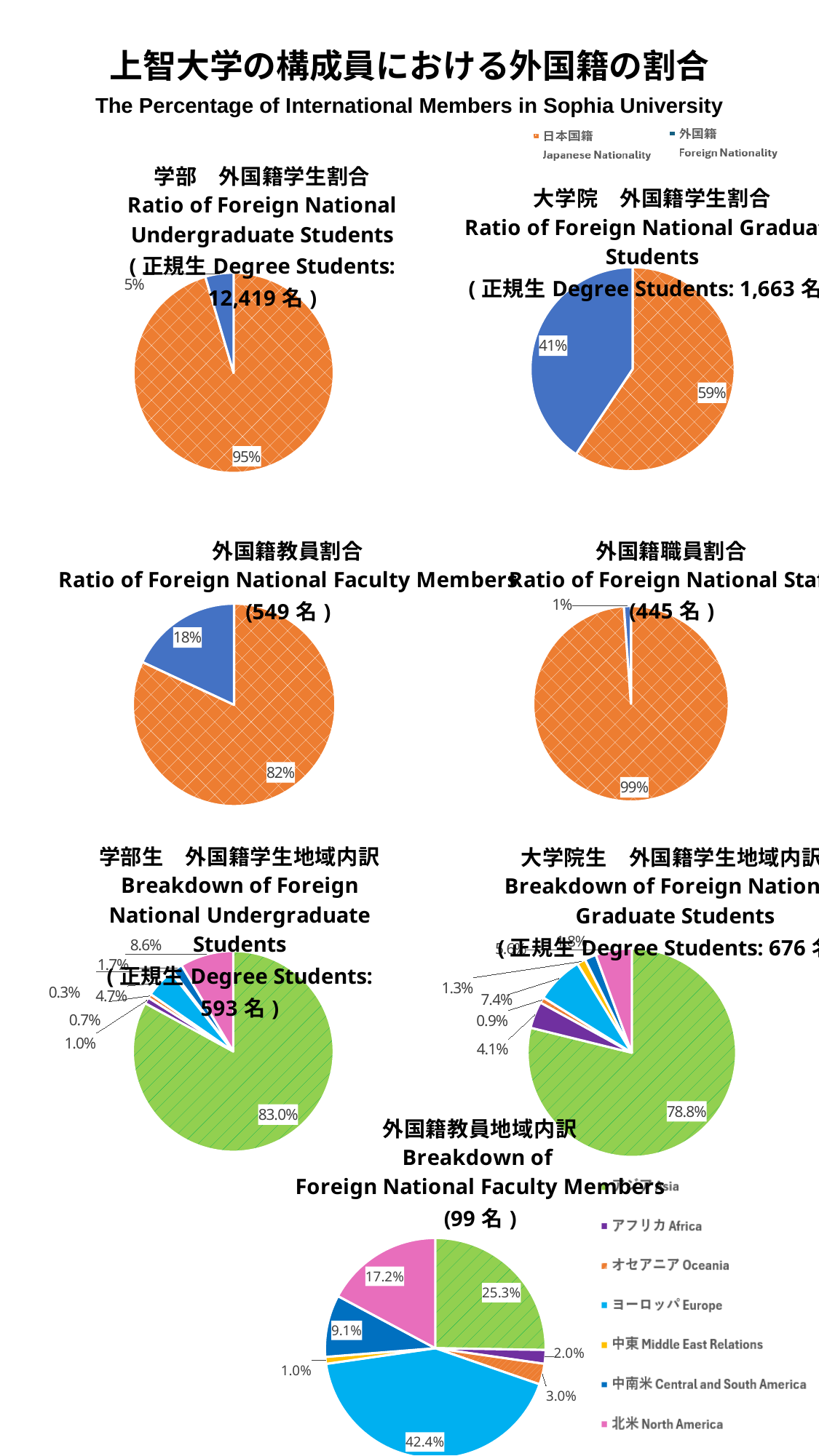
In the 'Breakdown of Foreign National Faculty Members' chart, what percentage is Europe? 42.4% In the 'Ratio of Foreign National Graduate Students' chart, how many percentage points larger is the Japanese Nationality share than the Foreign Nationality share? 18 percentage points In the 'Ratio of Foreign National Staff' chart, what percentage is Japanese Nationality? 99% In the 'Ratio of Foreign National Faculty Members' chart, what percentage is Foreign Nationality? 18% In the 'Ratio of Foreign National Undergraduate Students' chart, what percentage is Foreign Nationality? 5% In the 'Breakdown of Foreign National Faculty Members' chart, which region has the largest share? Europe In the 'Breakdown of Foreign National Faculty Members' chart, which region has the smallest share? Middle East How many regions does the legend for the breakdown charts list? 7 In the 'Breakdown of Foreign National Undergraduate Students' chart, what percentage is Asia? 83.0% In the 'Breakdown of Foreign National Faculty Members' chart, how many percentage points larger is Europe than Asia? 17.1 percentage points Which group has a larger share of Foreign Nationality: undergraduate students or graduate students? Graduate students In the 'Ratio of Foreign National Graduate Students' chart, what percentage is Japanese Nationality? 59%